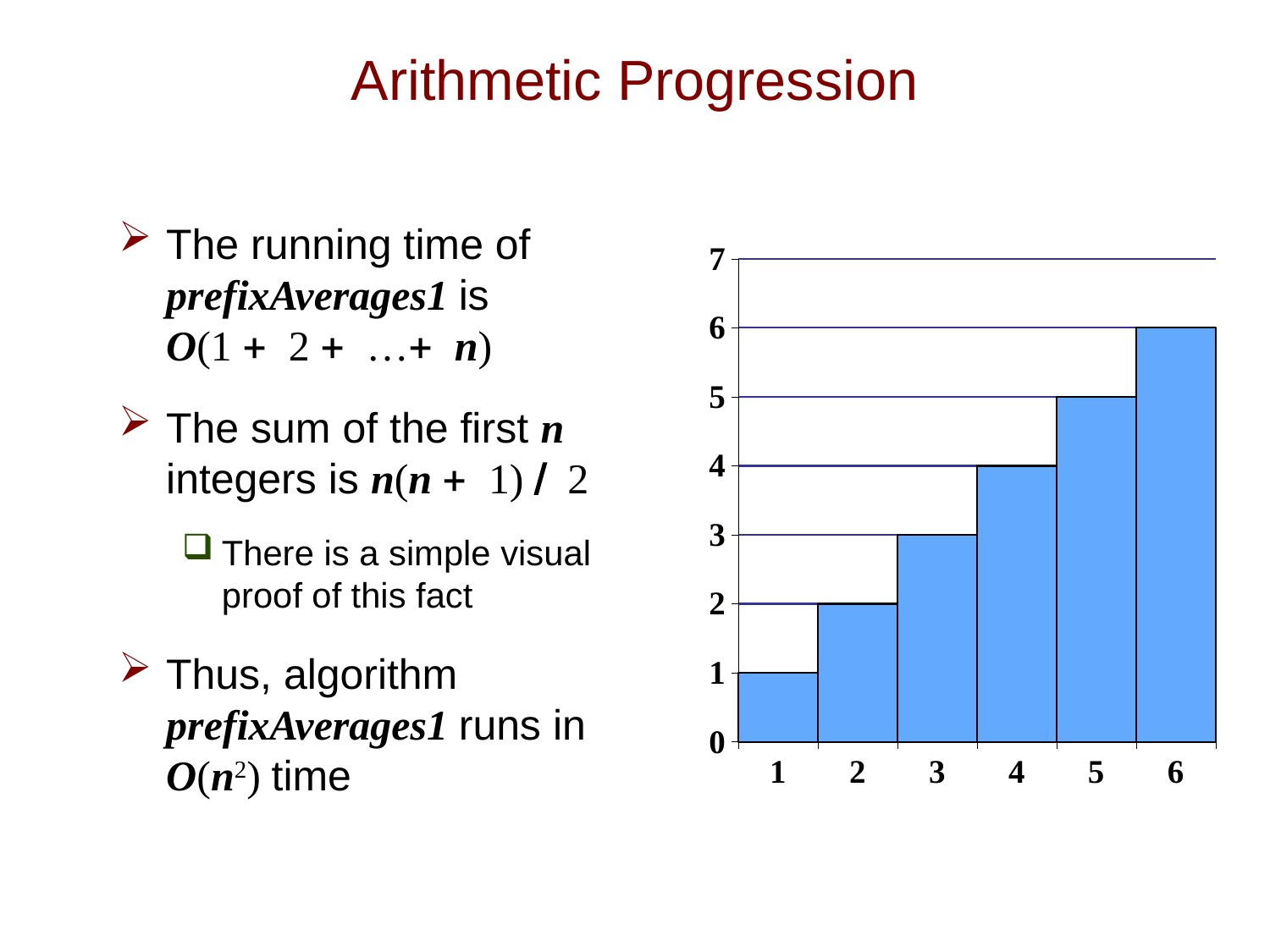
How many bars does the chart have? 6 What colour are the bars in the chart? blue Which is larger, the bar for category 3 or the bar for category 5? 5 What kind of chart is shown on the slide? bar chart Which category has the highest bar? 6 What is the value of the bar for category 4? 4 What is the difference between the values for category 6 and category 2? 4 Do the bar values rise or fall from left to right along the x axis? rise Is the value for category 5 greater or less than 3? greater What is the value of the bar for category 1? 1 Which category has the lowest bar? 1 What is the highest value labelled on the y axis? 7